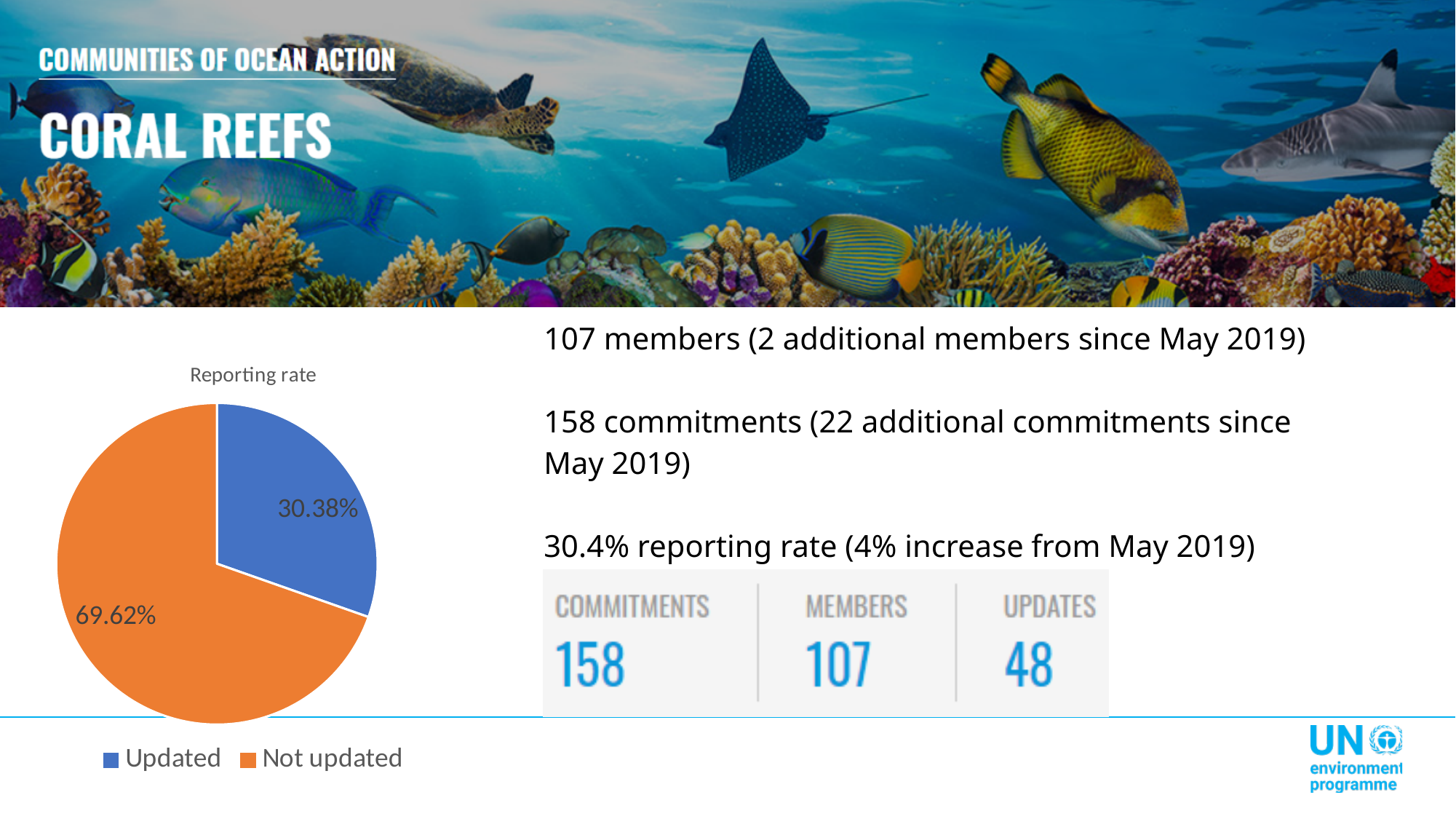
How many slices does the pie chart have? 2 What is the title of the chart? Reporting rate What share of the pie is labelled "Not updated"? 69.62% Which slice of the pie is the smallest? Updated What is the difference in percentage points between the "Not updated" and "Updated" slices? 39.24% What share of the pie is labelled "Updated"? 30.38% What colour is the "Not updated" slice? orange What kind of chart is shown on the slide? pie chart How many entries does the legend list? 2 Is the share for "Updated" greater or less than 50%? less Which slice of the pie is the largest? Not updated Which is larger, the "Updated" slice or the "Not updated" slice? Not updated